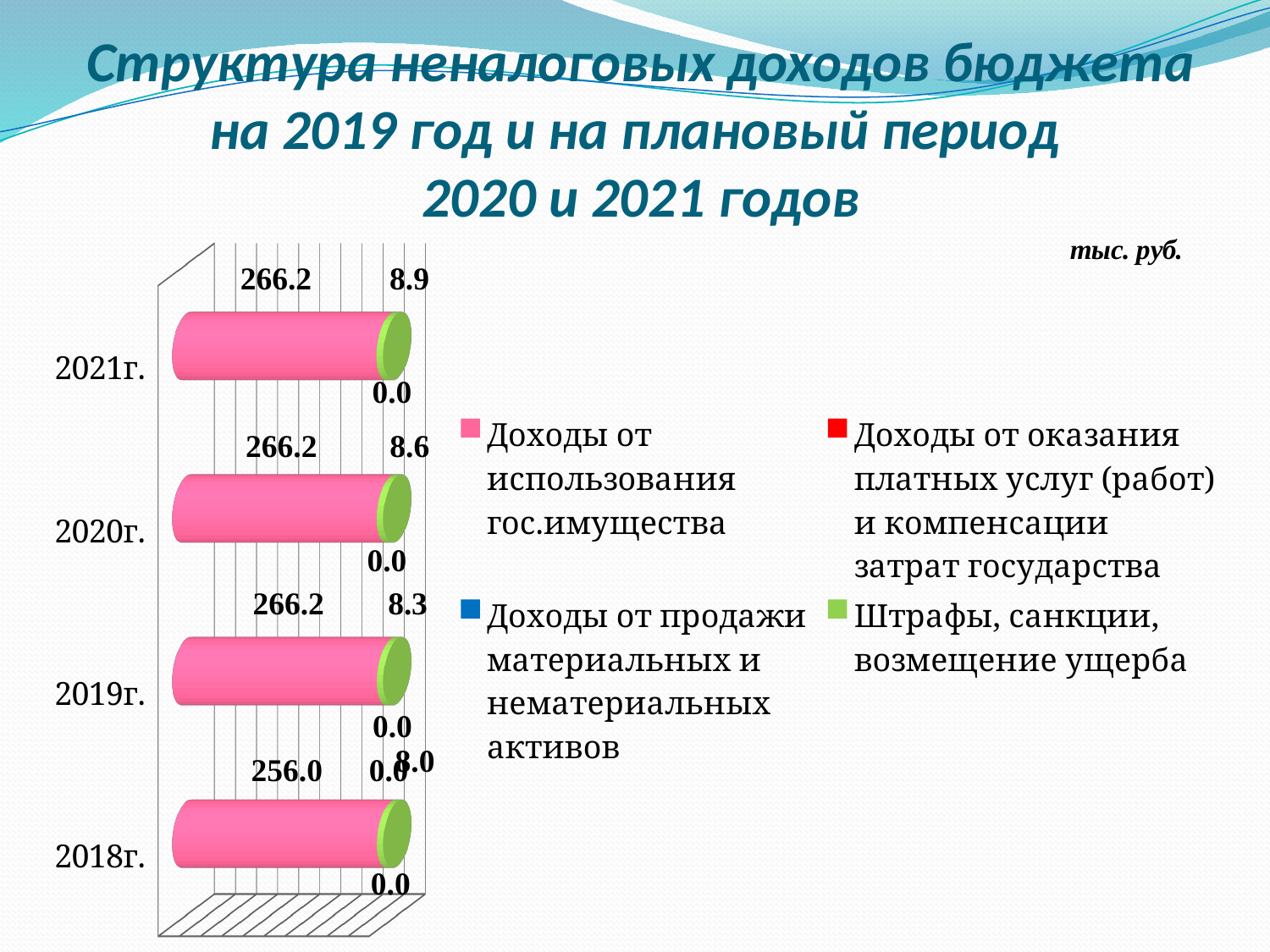
In which year is the value of 'Штрафы, санкции, возмещение ущерба' the highest? 2021г. What is the value of 'Доходы от использования гос.имущества' for 2018г.? 256.0 What is the difference between the 'Доходы от использования гос.имущества' values for 2019г. and 2018г.? 10.2 In which year is the value of 'Доходы от использования гос.имущества' the lowest? 2018г. What is the total of the stacked bar for 2021г.? 275.1 What is the value of 'Доходы от использования гос.имущества' for 2021г.? 266.2 How many years (categories) are shown on the chart? 4 How many series does the chart legend list? 4 What type of chart is shown on the slide? bar chart What is the value of 'Штрафы, санкции, возмещение ущерба' for 2020г.? 8.6 Does the value of 'Штрафы, санкции, возмещение ущерба' rise or fall from 2018г. to 2021г.? rise What is the value of 'Штрафы, санкции, возмещение ущерба' for 2019г.? 8.3